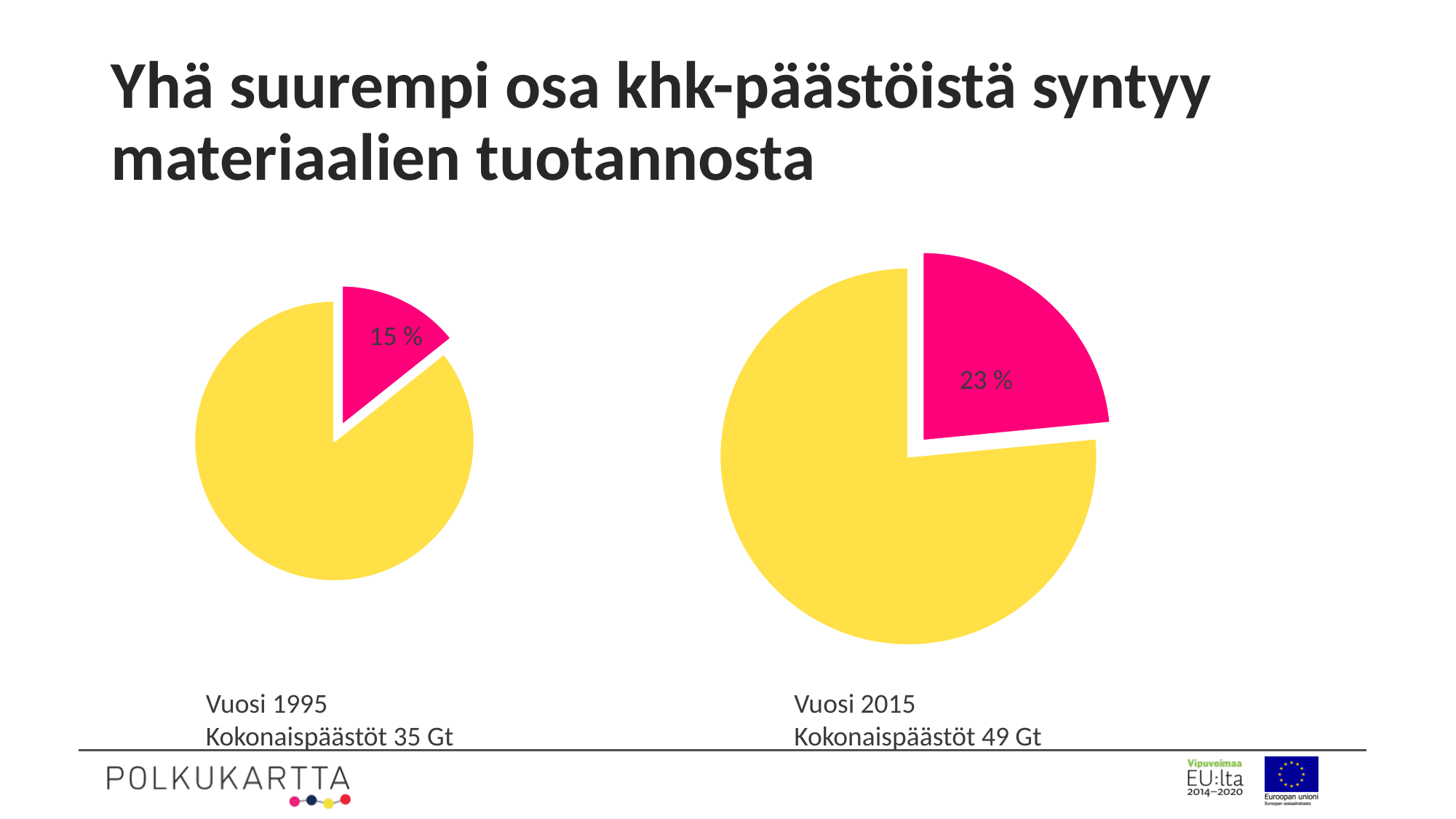
How many slices does the Vuosi 2015 pie chart have? 2 In the right pie chart (Vuosi 2015), what share does the pink slice represent? 23 % What are the total emissions (Kokonaispäästöt) stated for the Vuosi 2015 pie chart? 49 Gt What colour is the highlighted (exploded) slice in both pie charts? pink By how many percentage points is the pink share in the Vuosi 2015 pie larger than in the Vuosi 1995 pie? 8 In the left pie chart (Vuosi 1995), what share does the pink slice represent? 15 % How many slices does the Vuosi 1995 pie chart have? 2 What is the difference in total emissions between the Vuosi 2015 and Vuosi 1995 charts? 14 Gt What are the total emissions (Kokonaispäästöt) stated for the Vuosi 1995 pie chart? 35 Gt Which pie chart has the larger pink slice, Vuosi 1995 or Vuosi 2015? Vuosi 2015 What kind of chart is shown for the year 1995 (left)? pie chart How many pie charts are shown on the slide? 2